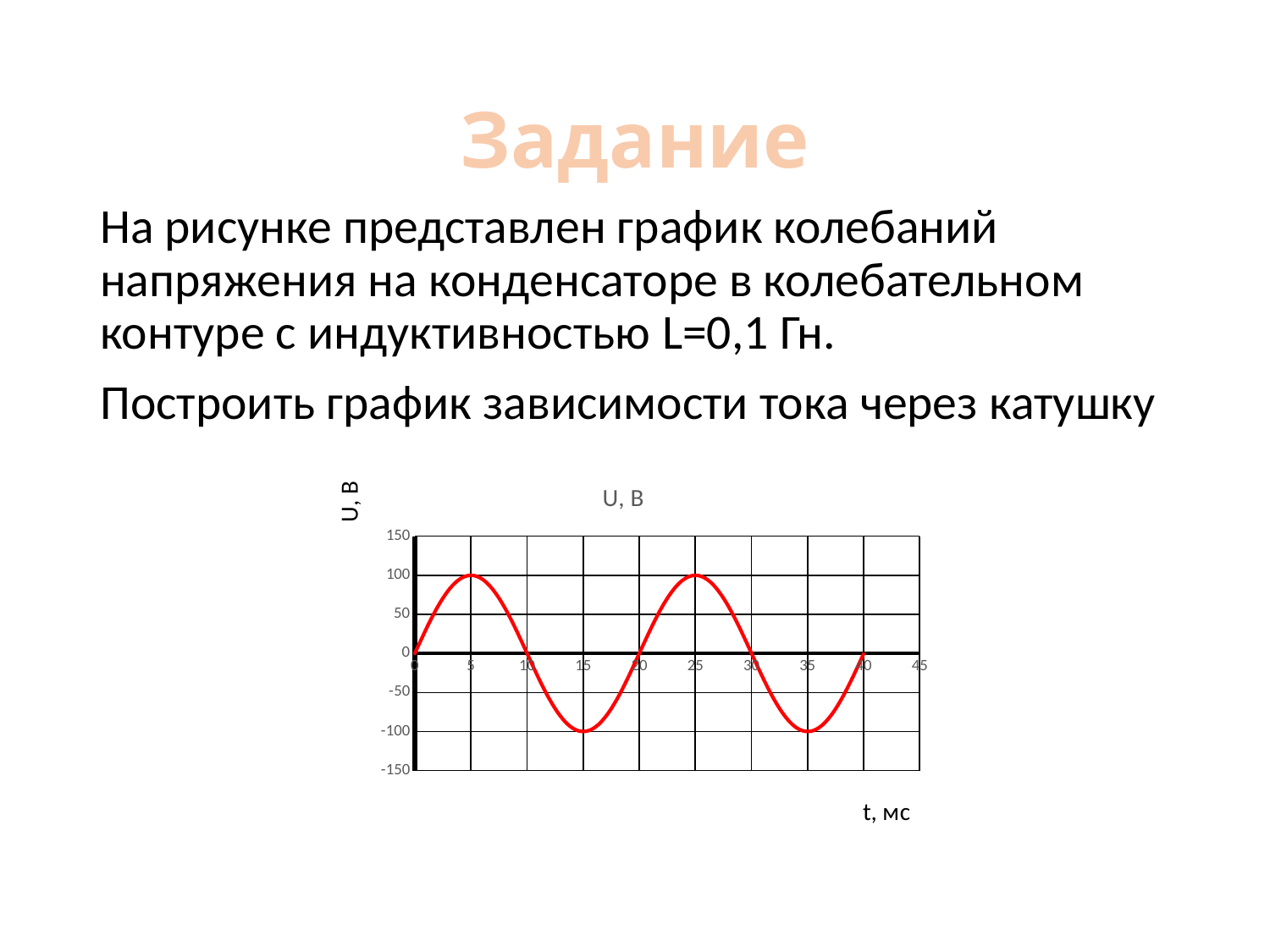
What is the value of U at t = 20 мс? 0 What is the value of U at t = 15 мс? -100 What is the lowest value the curve reaches? -100 Which is larger, the value of U at t = 5 мс or at t = 15 мс? t = 5 мс What is the value of U at t = 5 мс? 100 Is the value of U at t = 35 мс greater or less than -50? less What is the highest value the curve reaches? 100 Is the value of U at t = 25 мс greater or less than 50? greater What is the label of the horizontal axis of the chart? t, мс What is the title of the chart? U, В Between t = 5 мс and t = 15 мс, does the curve rise or fall? fall What kind of chart is shown on the slide? line chart